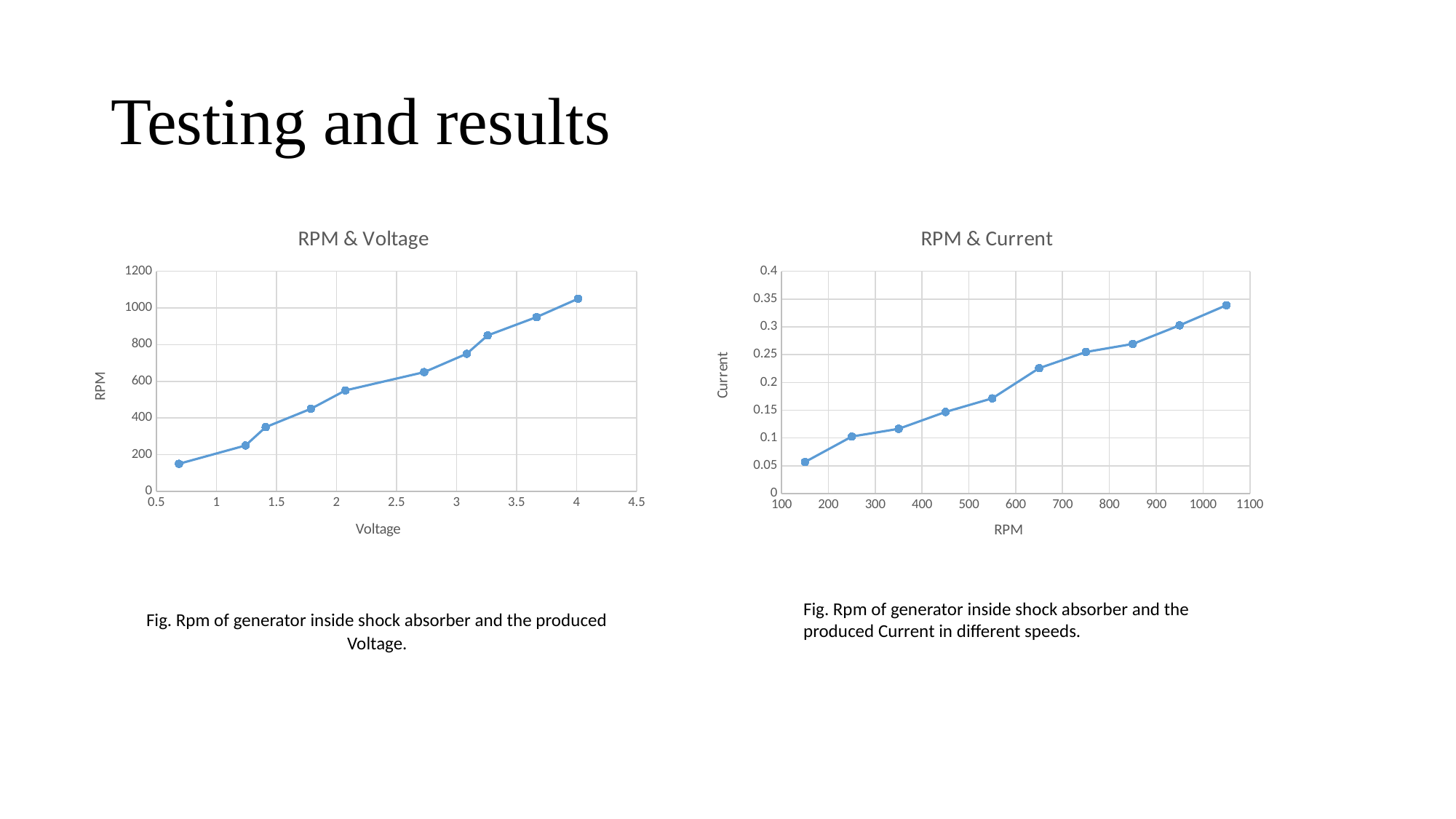
What is the x-axis label of the 'RPM & Voltage' chart? Voltage What type of chart is the 'RPM & Voltage' chart? line chart In the 'RPM & Voltage' chart, is the RPM of the rightmost (highest-voltage) point greater or less than 1000? greater In the 'RPM & Voltage' chart, how many data points are plotted? 10 In the 'RPM & Current' chart, does current rise or fall as RPM increases? rise In the 'RPM & Voltage' chart, do RPM values rise or fall as voltage increases? rise In the 'RPM & Current' chart, is the current of the leftmost (lowest-RPM) point greater or less than 0.1? less What type of chart is the 'RPM & Current' chart? line chart In the 'RPM & Current' chart, is the current of the rightmost (highest-RPM) point greater or less than 0.3? greater In the 'RPM & Current' chart, how many data points are plotted? 10 What is the y-axis label of the 'RPM & Current' chart? Current